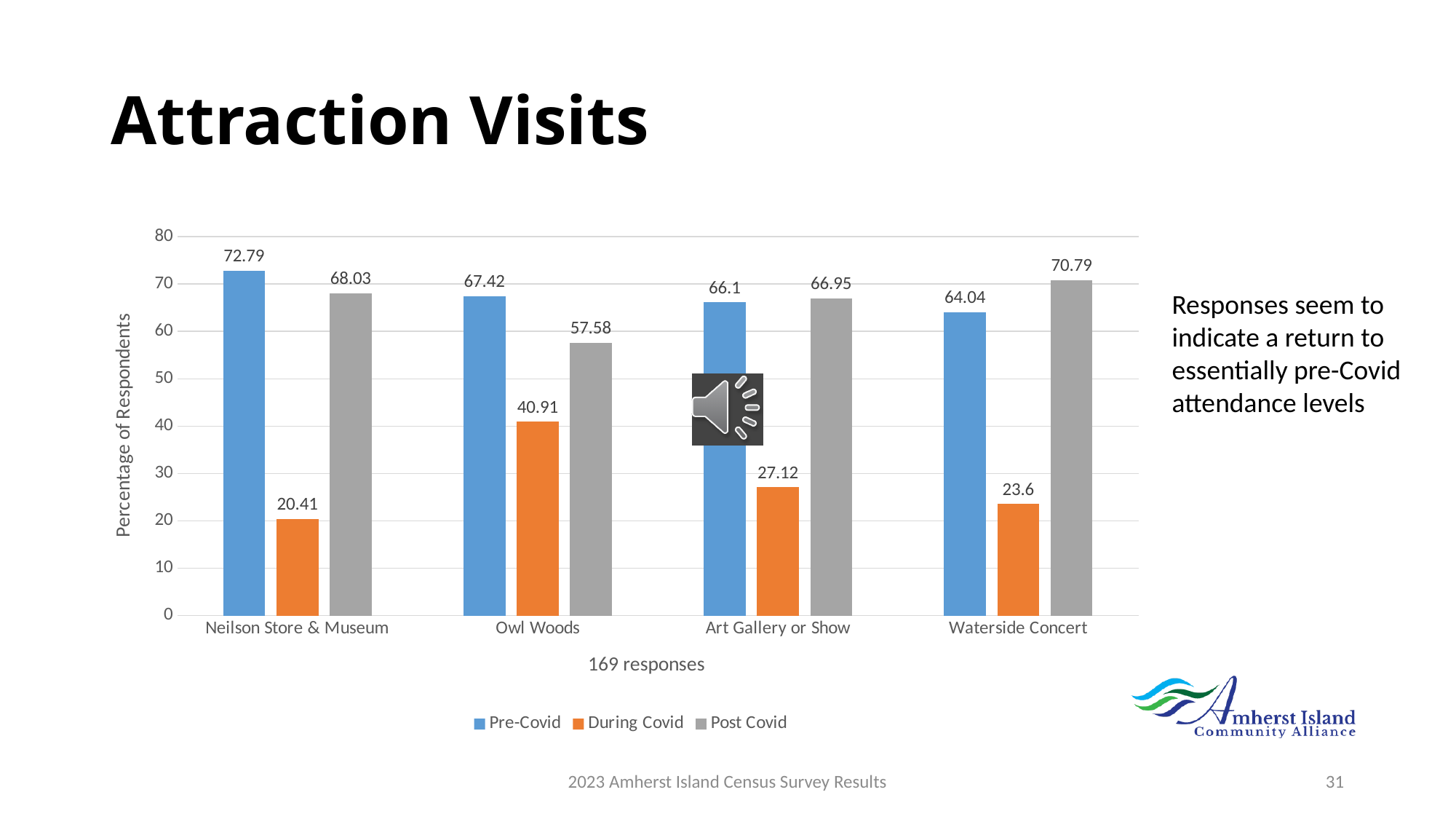
How many series does the legend list? 3 Is the During Covid value for Art Gallery or Show greater or less than 30? less What kind of chart is shown on the slide? Bar chart Which attraction has the highest During Covid value? Owl Woods What is the difference between the Pre-Covid and During Covid values for Neilson Store & Museum? 52.38 What is the Pre-Covid value for Neilson Store & Museum? 72.79 What is the difference between the Post Covid and Pre-Covid values for Waterside Concert? 6.75 How many attractions are shown on the x axis? 4 What is the During Covid value for Owl Woods? 40.91 What is the Post Covid value for Waterside Concert? 70.79 Which is larger for Owl Woods, the Pre-Covid value or the Post Covid value? Pre-Covid Which attraction has the lowest Pre-Covid value? Waterside Concert